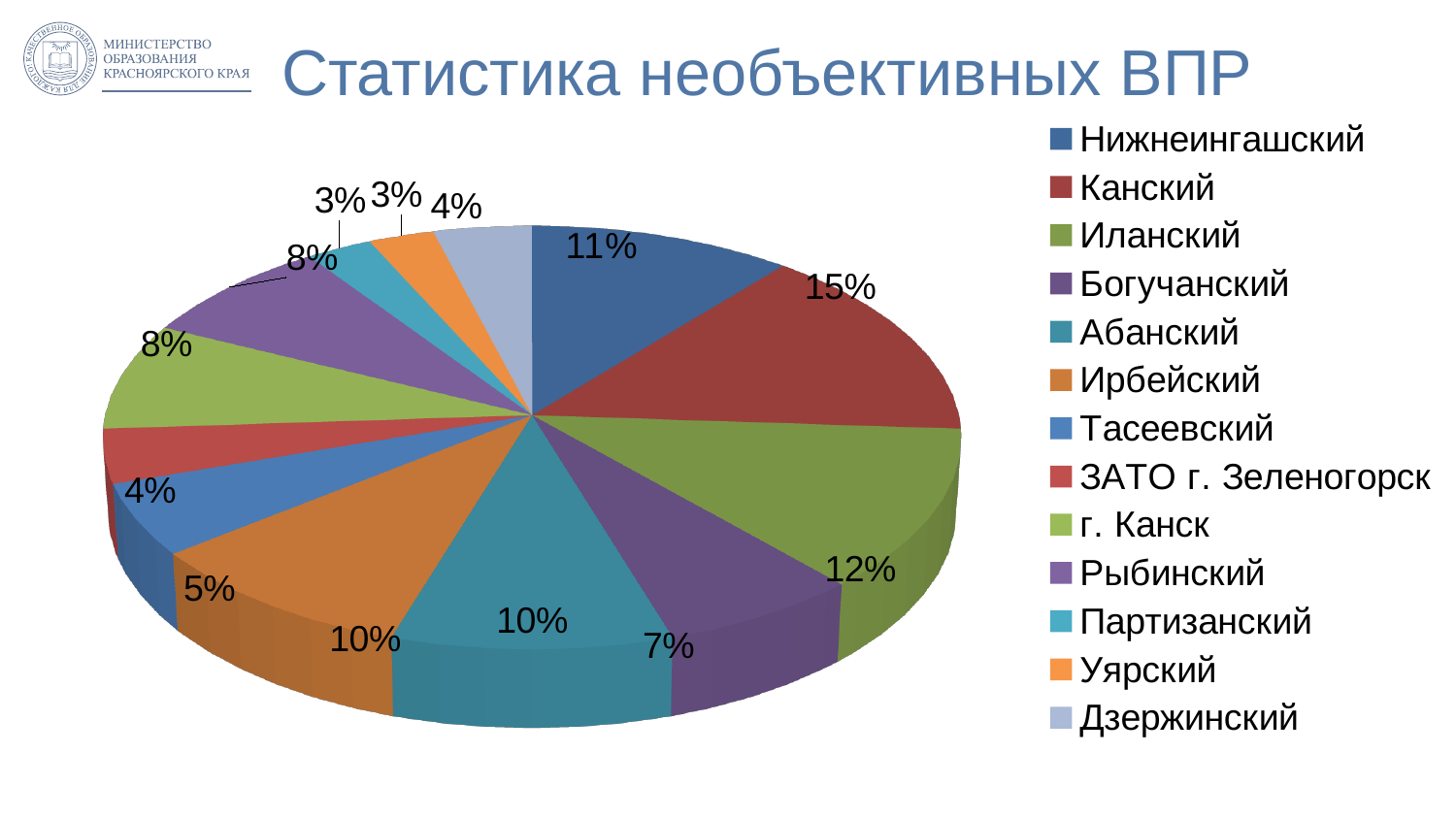
What share of the pie does Канский have? 15% What share of the pie does Богучанский have? 7% What share of the pie does Тасеевский have? 5% What is the difference between the shares of г. Канск and Уярский? 5% What type of chart is shown on the slide? pie chart Which has a larger share, Иланский or Абанский? Иланский What is the difference between the shares of Канский and Нижнеингашский? 4% What share of the pie does Иланский have? 12% Which category has the largest share of the pie? Канский What is the title of the chart? Статистика необъективных ВПР How many categories does the pie chart have? 13 What share of the pie does Дзержинский have? 4%